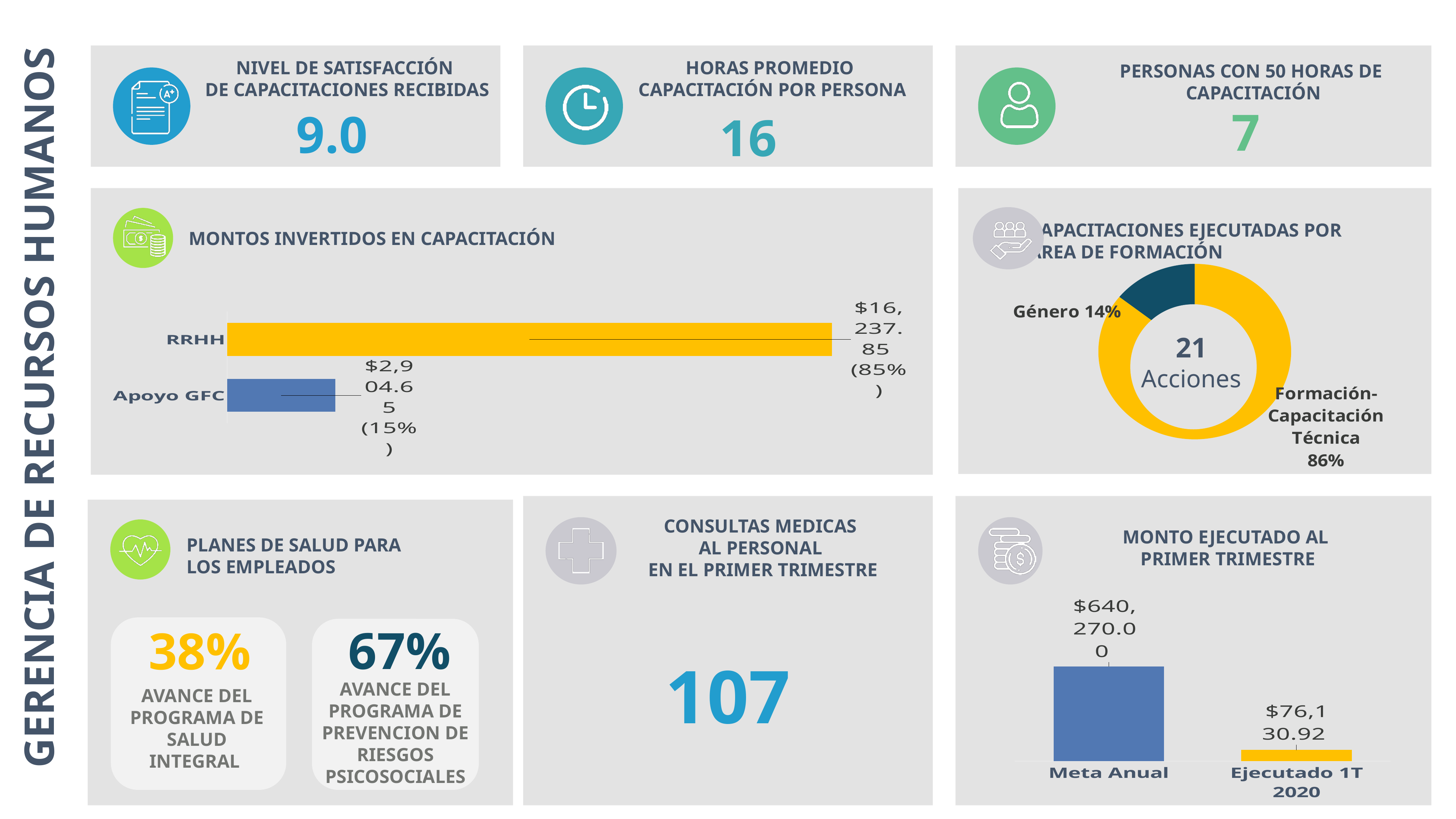
In the MONTOS INVERTIDOS EN CAPACITACIÓN chart, which category has the highest amount? RRHH In the MONTO EJECUTADO AL PRIMER TRIMESTRE chart, which is larger, Meta Anual or Ejecutado 1T 2020? Meta Anual What total number of actions is shown in the centre of the CAPACITACIONES EJECUTADAS POR ÁREA DE FORMACIÓN donut chart? 21 Acciones What kind of chart is the MONTOS INVERTIDOS EN CAPACITACIÓN chart? Bar chart In the MONTOS INVERTIDOS EN CAPACITACIÓN chart, what is the difference between the RRHH and Apoyo GFC amounts? $13,333.20 In the MONTOS INVERTIDOS EN CAPACITACIÓN chart, what is the value for Apoyo GFC? $2,904.65 (15%) In the MONTO EJECUTADO AL PRIMER TRIMESTRE chart, what is the value for Meta Anual? $640,270.00 In the CAPACITACIONES EJECUTADAS POR ÁREA DE FORMACIÓN chart, what share does Formación-Capacitación Técnica have? 86% In the MONTOS INVERTIDOS EN CAPACITACIÓN chart, what is the value for RRHH? $16,237.85 (85%) In the MONTO EJECUTADO AL PRIMER TRIMESTRE chart, what is the value for Ejecutado 1T 2020? $76,130.92 How many categories does the MONTOS INVERTIDOS EN CAPACITACIÓN chart show? 2 In the CAPACITACIONES EJECUTADAS POR ÁREA DE FORMACIÓN chart, what share does Género have? 14%